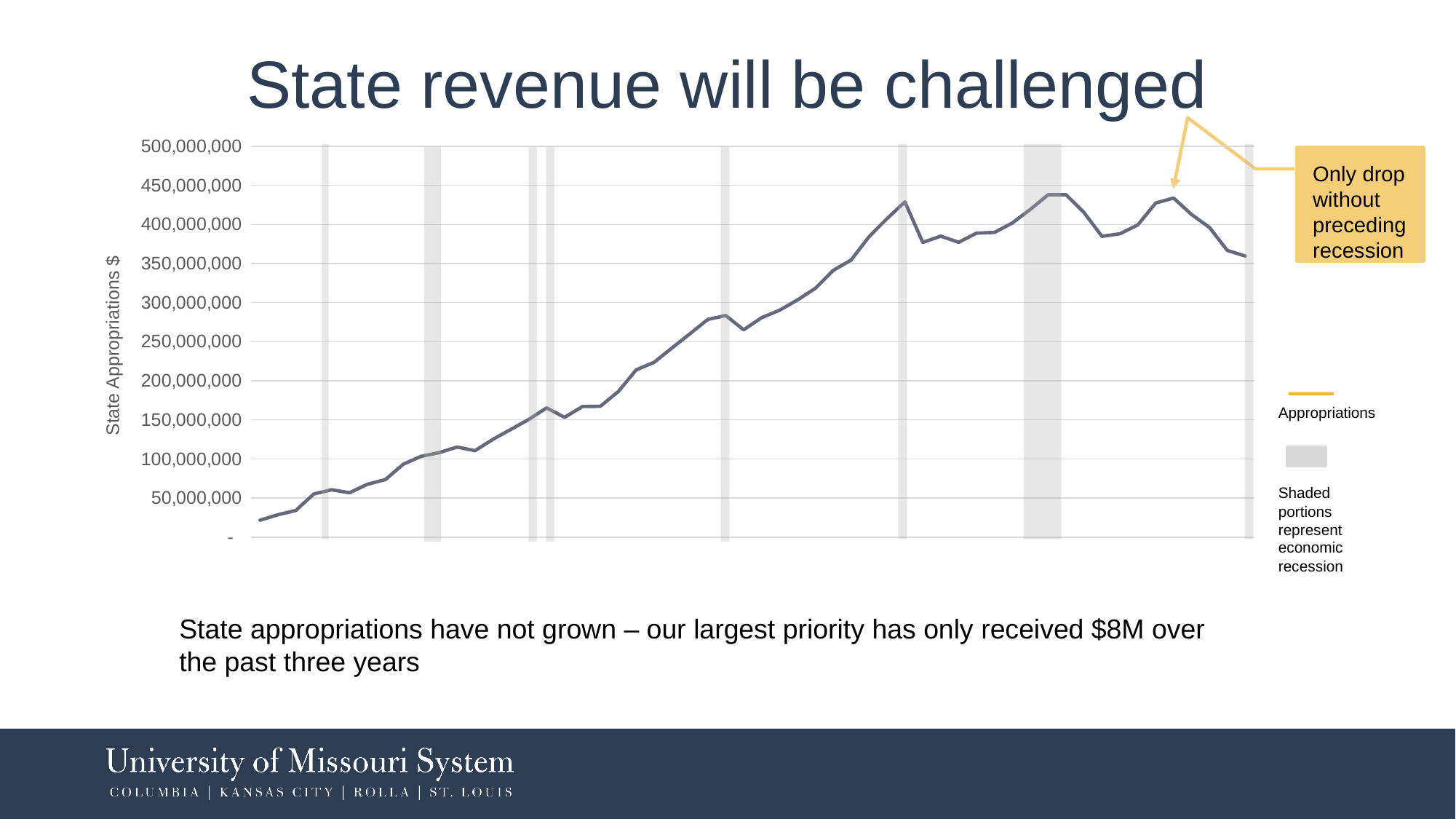
Is the last point on the Appropriations line greater or less than 350,000,000? greater What is the highest value shown on the vertical axis of the chart? 500,000,000 What is the label on the vertical axis of the chart? State Appropriations $ Is the first point on the Appropriations line greater or less than 50,000,000? less Overall, do the values of the Appropriations line rise or fall from left to right along the x axis? rise Which is larger, the first point or the last point on the Appropriations line? the last point Is the highest point on the Appropriations line greater or less than 400,000,000? greater What is the name of the series plotted in the chart? Appropriations How many data series does the chart's legend list? 1 What kind of chart is shown on the slide? line chart